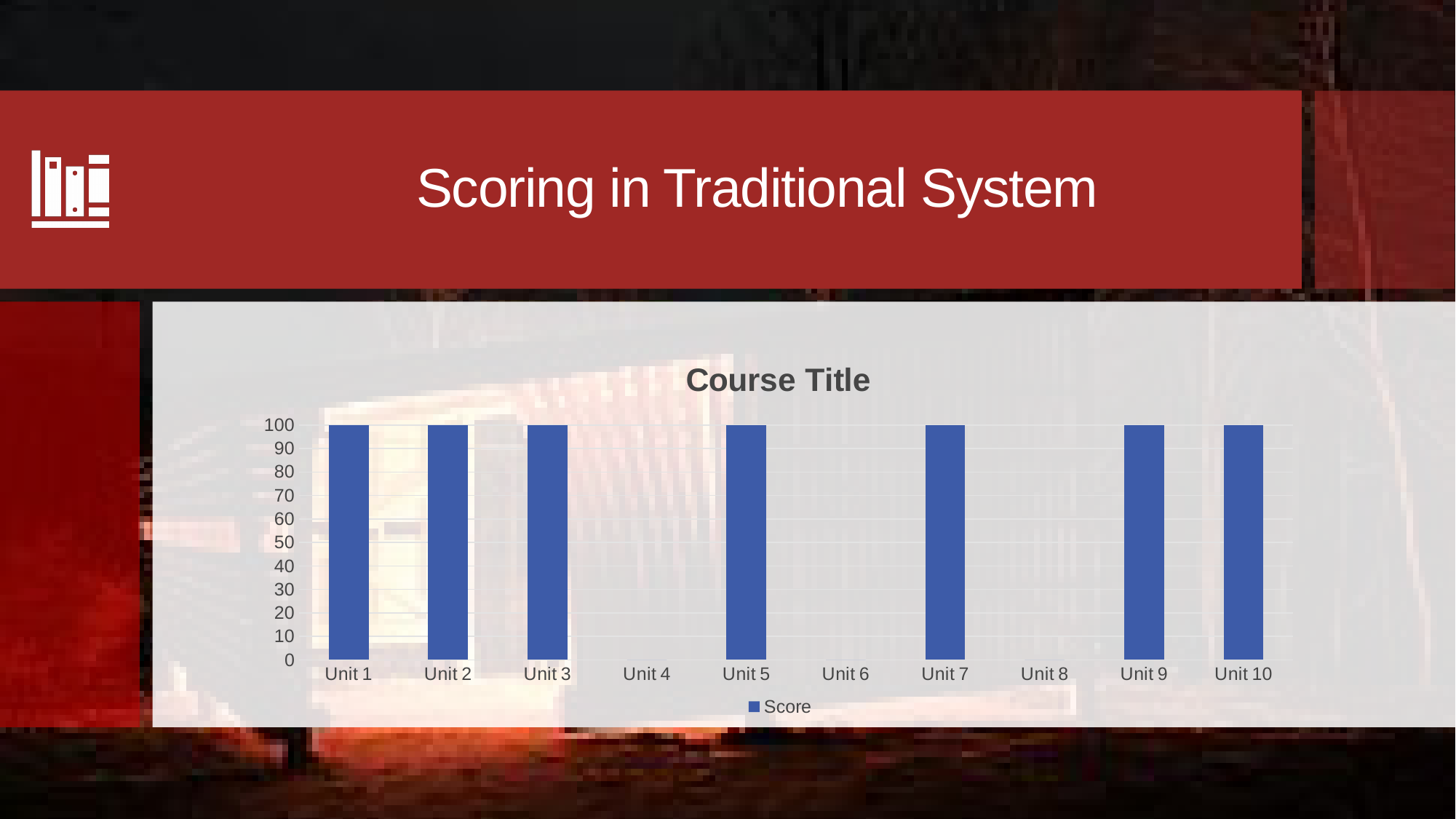
What is the difference between the Score for Unit 2 and the Score for Unit 9? 0 Which has the larger Score, Unit 3 or Unit 4? Unit 3 How many series does the chart's legend list? 1 What is the name of the series listed in the chart's legend? Score How many units are shown on the x axis of the chart? 10 How many units have a bar reaching 100? 7 What kind of chart is shown on the slide? Bar chart What is the Score for Unit 7? 100 What is the Score for Unit 1? 100 Is the value for Unit 5 greater or less than 50? greater What is the title of the chart? Course Title Which units show no visible bar in the chart? Unit 4, Unit 6, Unit 8